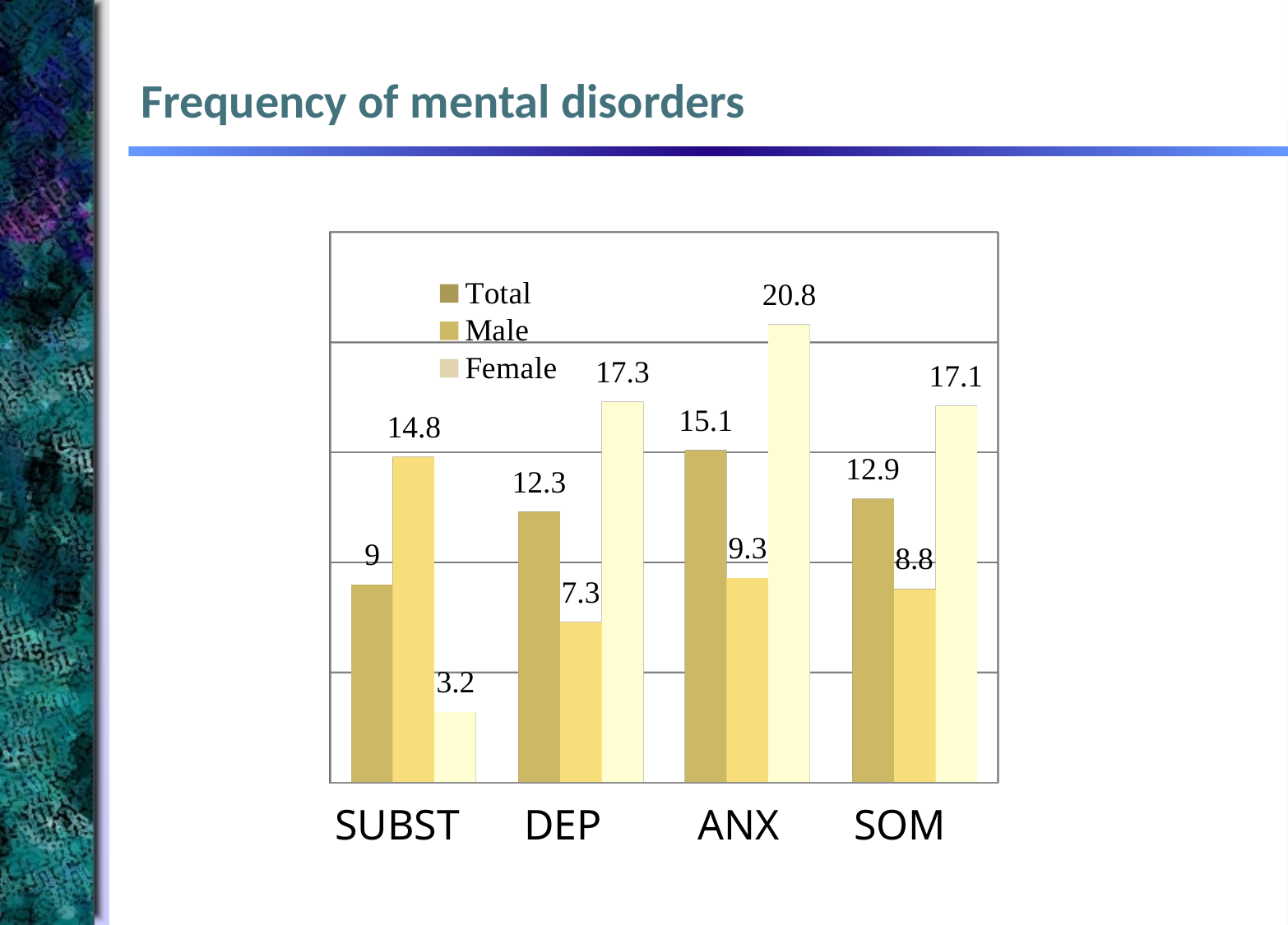
What is the Male value for DEP? 7.3 What is the Total value for ANX? 15.1 Which category has the highest Female value? ANX What kind of chart is shown on the slide? Bar chart What is the title of the slide? Frequency of mental disorders How many categories are shown on the x axis? 4 Which category has the lowest Total value? SUBST What is the Female value for SUBST? 3.2 How many series does the legend list? 3 Which is larger for SOM, the Male value or the Female value? Female What is the difference between the Male values for SUBST and SOM? 6 What is the difference between the Female and Male values for ANX? 11.5